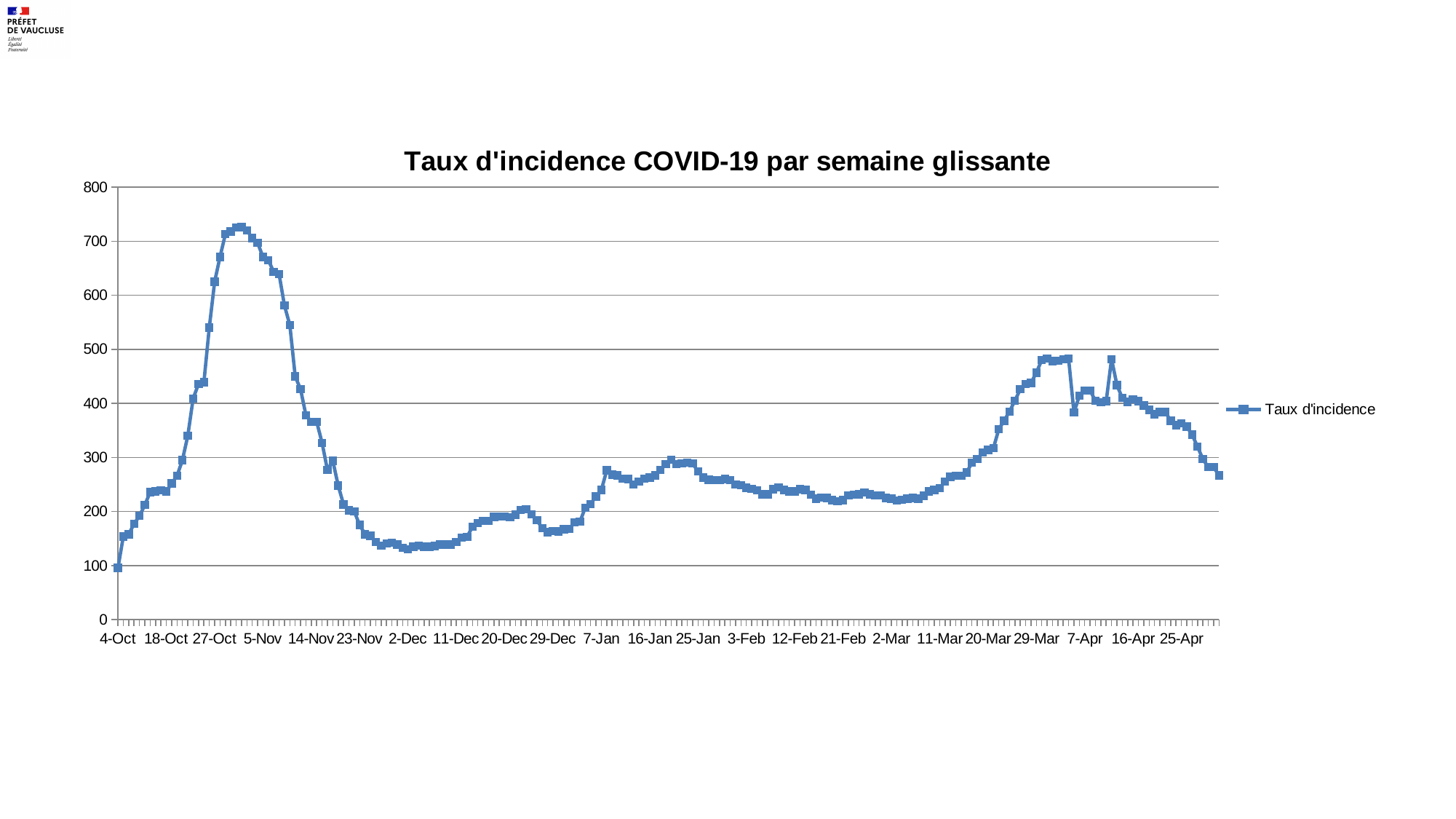
What is the name of the series shown in the legend? Taux d'incidence Is the value for 2-Dec greater or less than 200? less Do the values rise or fall between 11-Mar and 29-Mar? rise What kind of chart is shown on the slide? line chart How many series does the legend list? 1 What is the title of the chart? Taux d'incidence COVID-19 par semaine glissante Which is larger, the value for 5-Nov or the value for 29-Mar? 5-Nov Is the highest value on the chart greater or less than 700? greater Do the values rise or fall between 5-Nov and 2-Dec? fall Is the value for 29-Mar greater or less than 400? greater